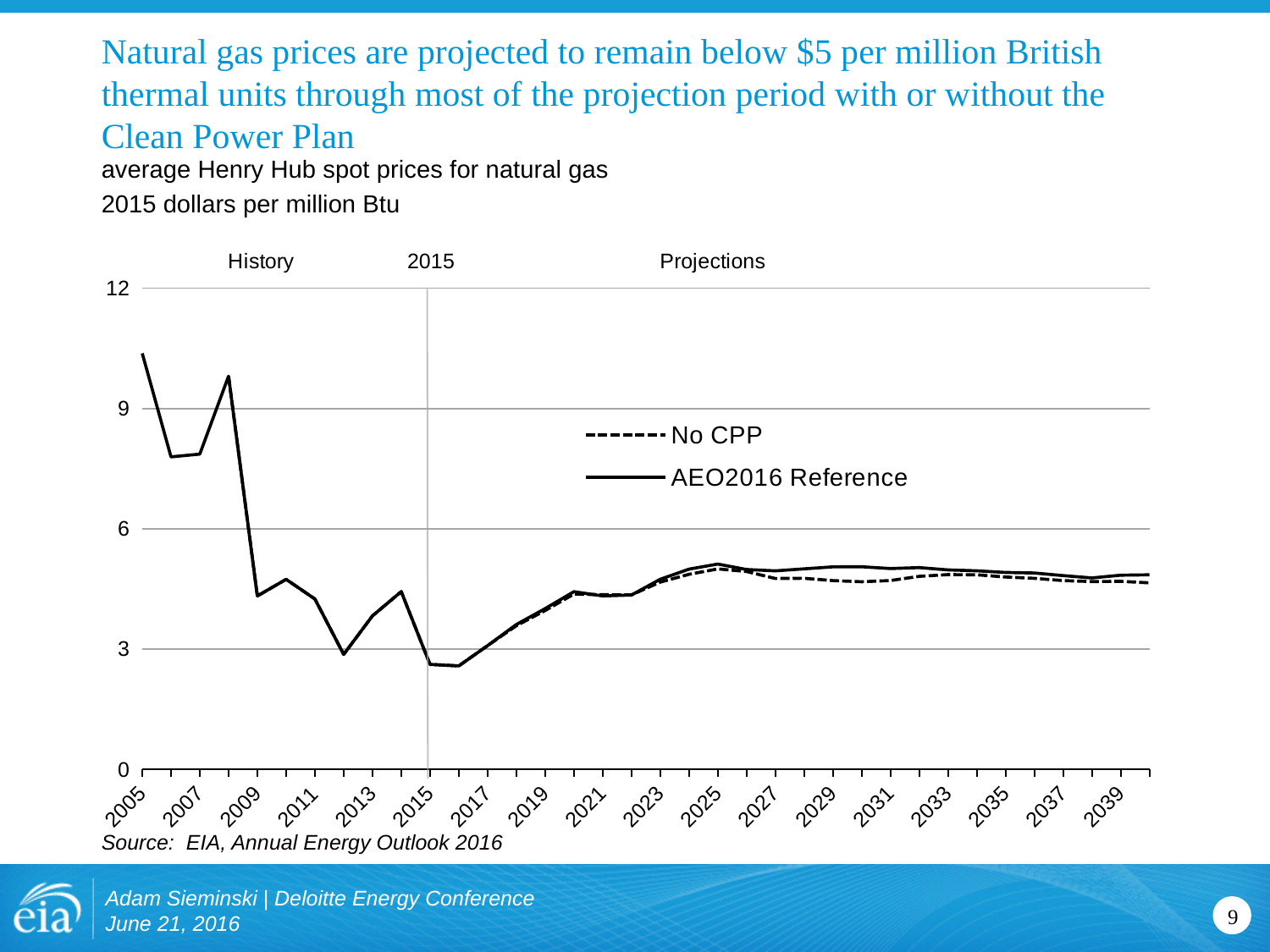
What unit is given for the values on the chart? 2015 dollars per million Btu What kind of chart is shown on the slide? line chart Do natural gas prices generally rise or fall between 2005 and 2015? fall How many series does the legend list? 2 Which year has the higher natural gas price, 2005 or 2015? 2005 What are the two series named in the legend? No CPP and AEO2016 Reference Is the AEO2016 Reference price in 2025 greater or less than 6? less Is the natural gas price in 2005 greater or less than 9? greater In 2030, which series shows the higher price, No CPP or AEO2016 Reference? AEO2016 Reference Do projected natural gas prices rise or fall between 2015 and 2025? rise Is the natural gas price in 2015 greater or less than 3? less